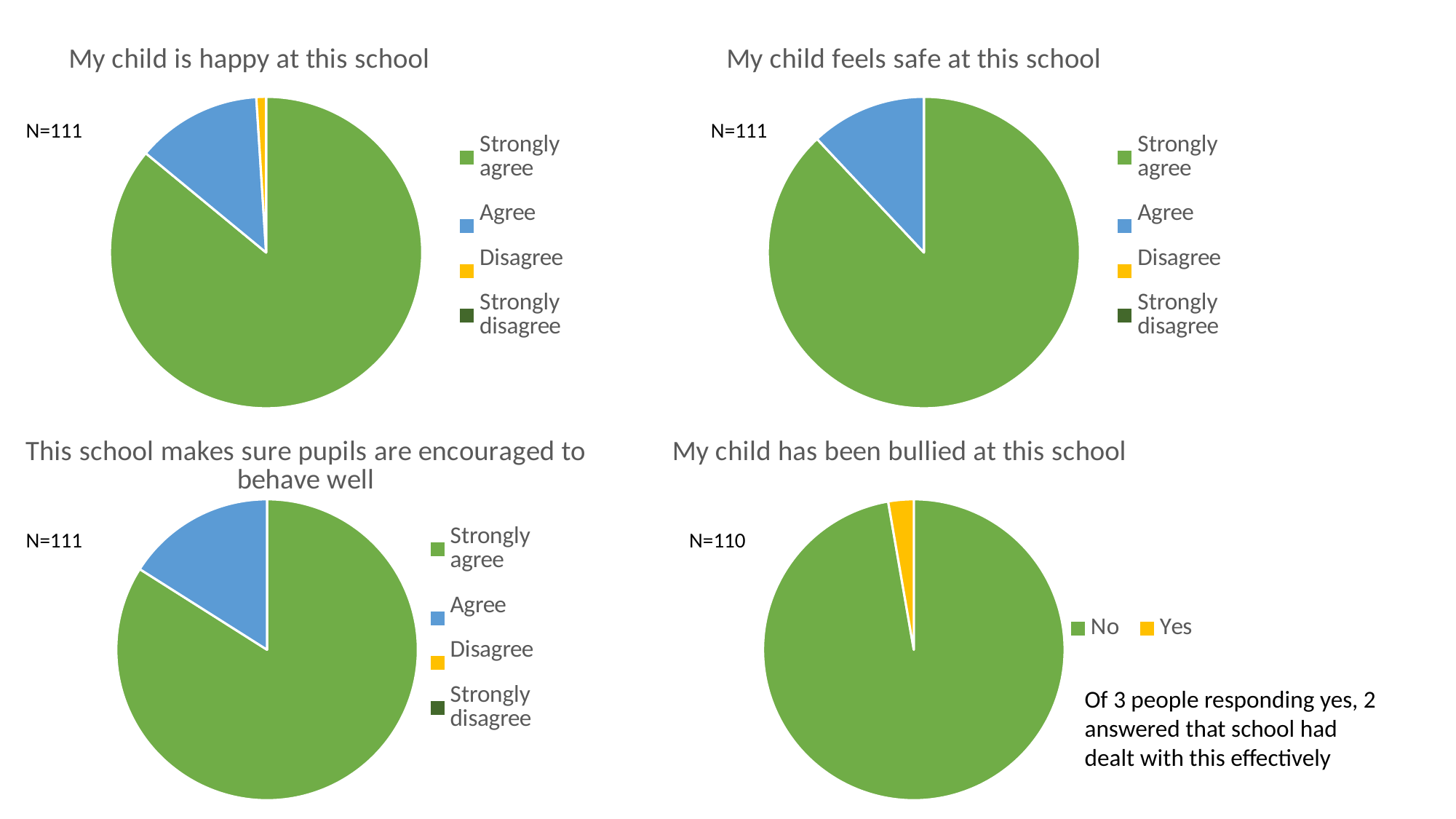
In the chart 'My child is happy at this school', which response has the largest slice? Strongly agree In the chart 'This school makes sure pupils are encouraged to behave well', which response has the largest slice? Strongly agree In the chart 'My child has been bullied at this school', which response has the smallest slice? Yes In the chart 'My child is happy at this school', which slice is larger, Agree or Disagree? Agree In the chart 'My child feels safe at this school', which is larger, Strongly agree or Agree? Strongly agree What kind of chart is 'My child has been bullied at this school'? Pie chart How many entries does the legend of 'My child feels safe at this school' list? 4 What N value is shown for the chart 'My child has been bullied at this school'? N=110 What kind of chart is 'My child is happy at this school'? Pie chart How many entries does the legend of 'My child has been bullied at this school' list? 2 In the chart 'My child has been bullied at this school', which slice is larger, No or Yes? No What N value is shown for the chart 'This school makes sure pupils are encouraged to behave well'? N=111